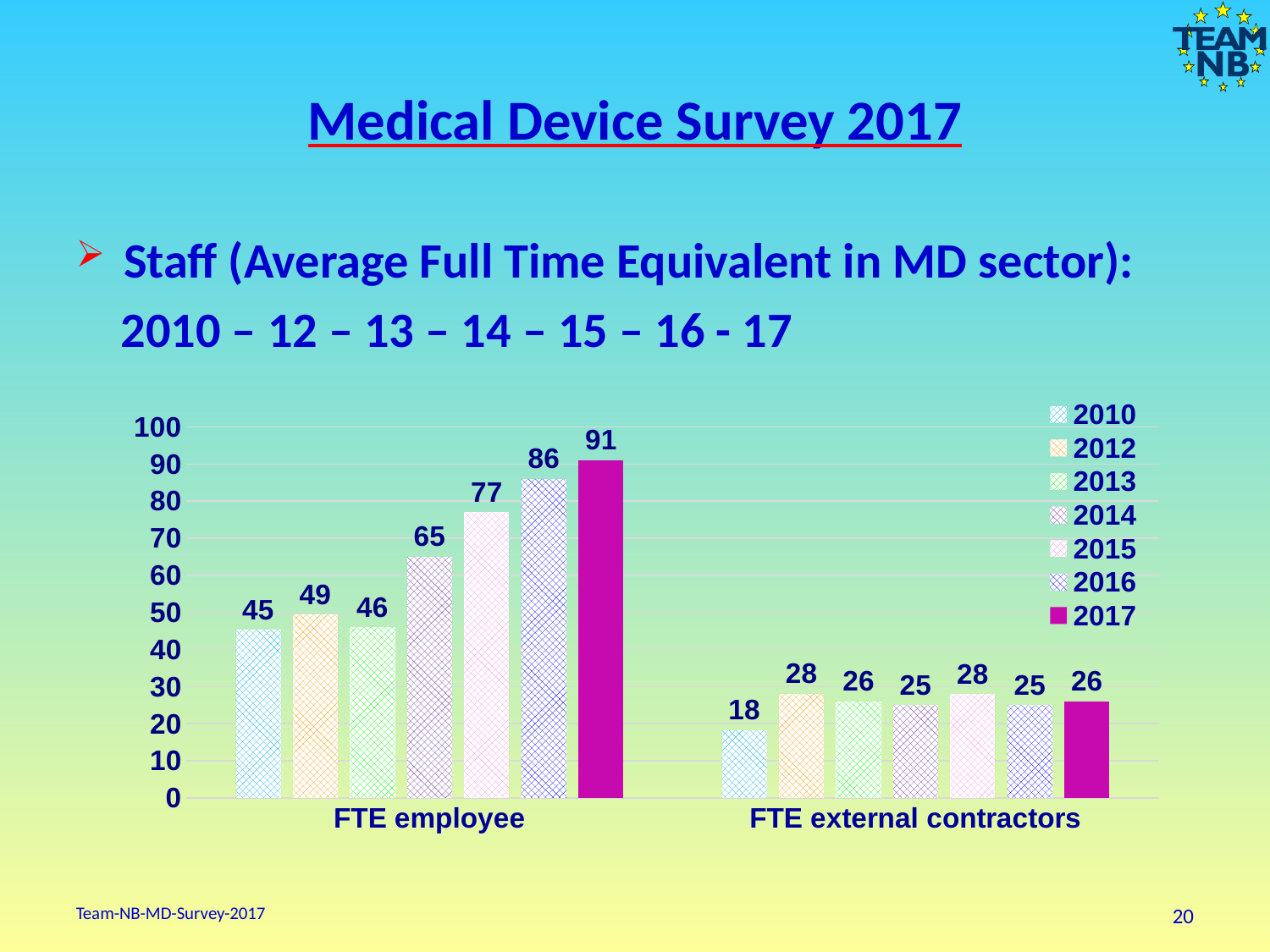
What kind of chart is shown on the slide? bar chart Which series is shown with a solid magenta fill in the legend? 2017 Is the value for FTE employee in 2016 greater or less than 80? greater How many series does the legend list? 7 What is the value for FTE employee in 2017? 91 How many categories are shown on the x axis? 2 What is the value for FTE employee in 2014? 65 Which year has the lowest value for FTE external contractors? 2010 Which year has the highest value for FTE employee? 2017 What is the value for FTE external contractors in 2010? 18 Which is larger for FTE external contractors: the 2012 value or the 2017 value? 2012 What is the difference between the FTE employee values for 2017 and 2010? 46